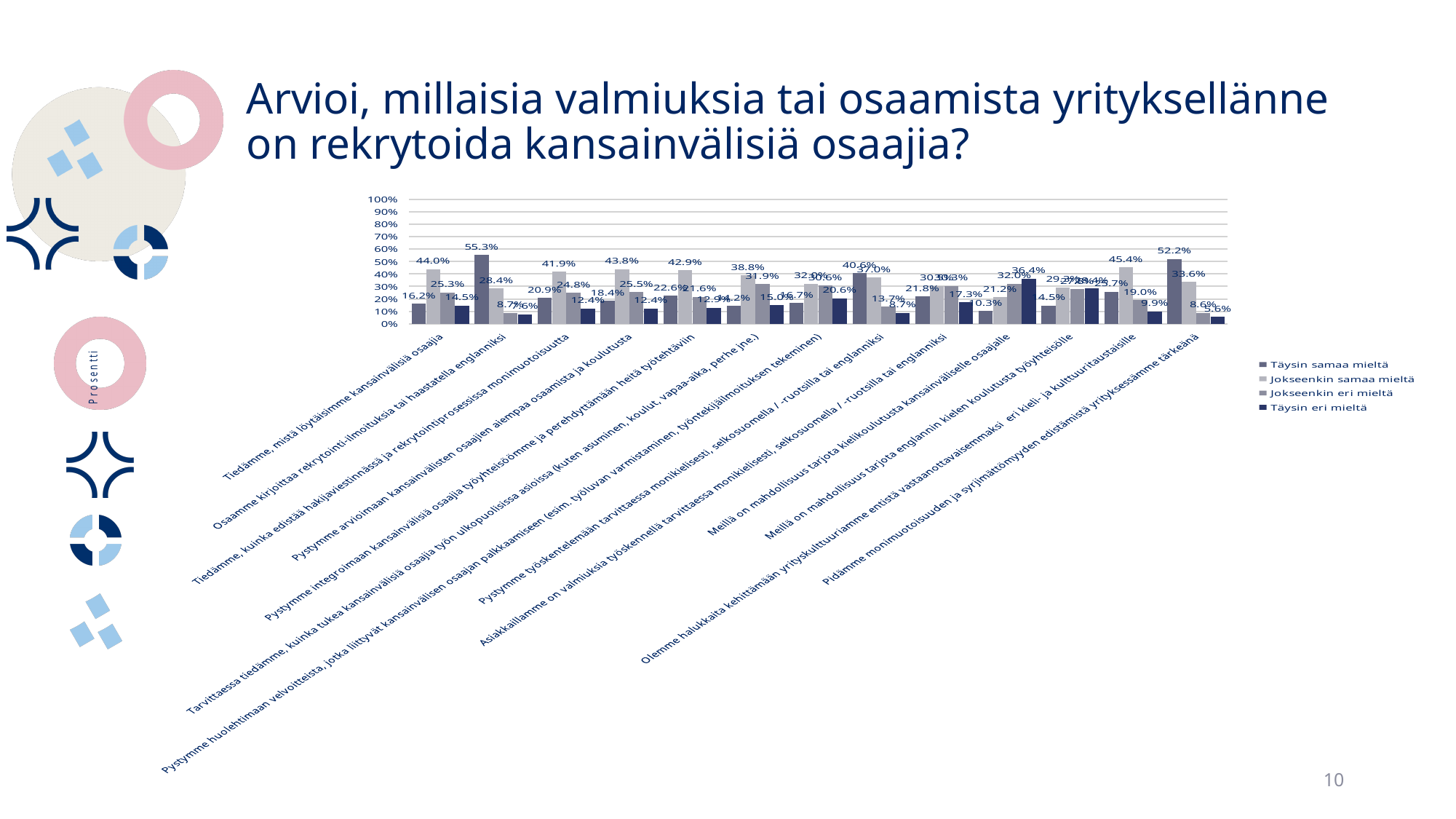
How many series does the legend list? 4 What is the name of the last legend entry? Täysin eri mieltä What is the value of 'Täysin samaa mieltä' for 'Osaamme kirjoittaa rekrytointi-ilmoituksia tai haastatella englanniksi'? 55.3% For 'Olemme halukkaita kehittämään yrityskulttuuriamme entistä vastaanottavaisemmaksi eri kieli- ja kulttuuritaustaisille', which is larger: 'Jokseenkin samaa mieltä' or 'Täysin samaa mieltä'? Jokseenkin samaa mieltä Is the 'Jokseenkin samaa mieltä' value for 'Pystymme arvioimaan kansainvälisten osaajien aiempaa osaamista ja koulutusta' greater or less than 40%? greater What is the difference between the 'Täysin samaa mieltä' and 'Jokseenkin samaa mieltä' values for 'Pystymme työskentelemään tarvittaessa monikielisesti, selkosuomella / -ruotsilla tai englanniksi'? 3.6% What kind of chart is shown on the slide? bar chart Which category has the lowest 'Täysin eri mieltä' value? Pidämme monimuotoisuuden ja syrjimättömyyden edistämistä yrityksessämme tärkeänä What is the value of 'Täysin samaa mieltä' for 'Pidämme monimuotoisuuden ja syrjimättömyyden edistämistä yrityksessämme tärkeänä'? 52.2% What is the value of 'Jokseenkin samaa mieltä' for 'Tiedämme, mistä löytäisimme kansainvälisiä osaajia'? 44.0% Which category has the highest 'Täysin samaa mieltä' value? Osaamme kirjoittaa rekrytointi-ilmoituksia tai haastatella englanniksi What is the value of 'Täysin eri mieltä' for 'Meillä on mahdollisuus tarjota kielikoulutusta kansainväliselle osaajalle'? 36.4%